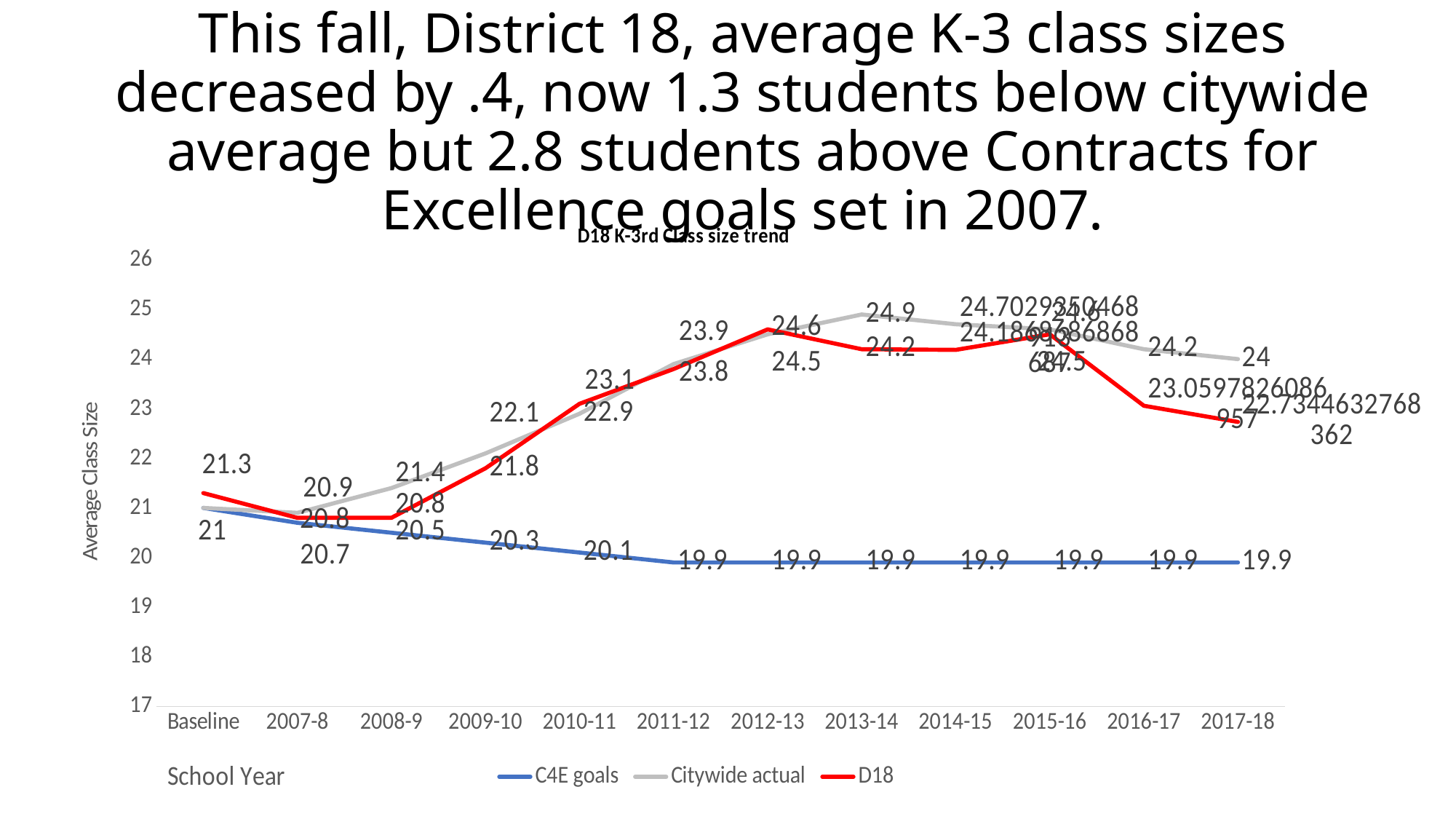
What is the Citywide actual value for 2013-14? 24.9 How many school-year categories are shown on the x axis? 12 In which school year does the Citywide actual series reach its highest value? 2013-14 What type of chart is shown on the slide? line chart What is the D18 value at Baseline? 21.3 In 2017-18, which is larger: Citywide actual or C4E goals? Citywide actual What is the C4E goals value for 2017-18? 19.9 What is the difference between Citywide actual and C4E goals in 2017-18? 4.1 What is the title of the y axis? Average Class Size What is the D18 value for 2012-13? 24.6 How many series does the legend list? 3 What is the Citywide actual value for 2017-18? 24